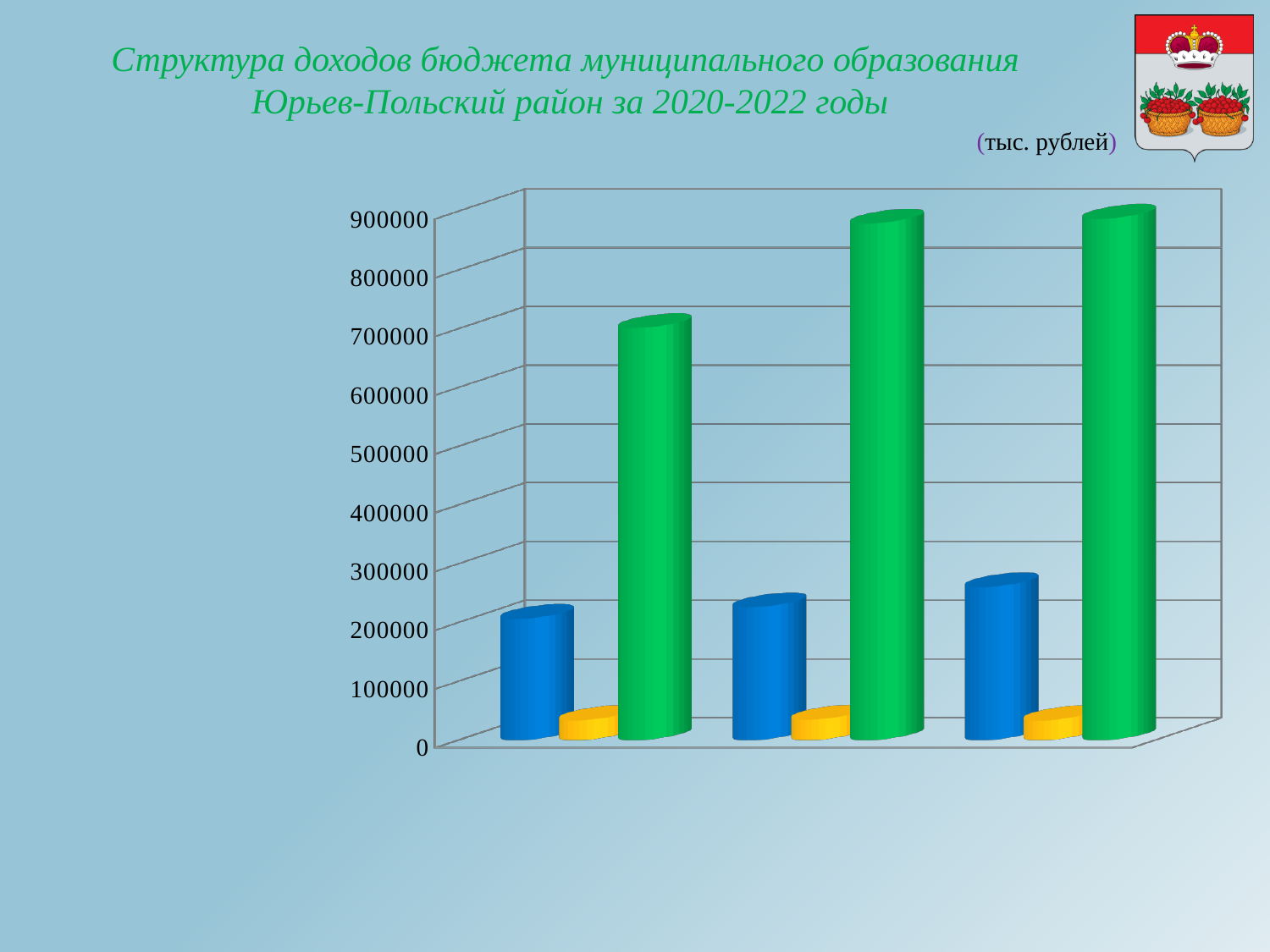
Is the value of the green bar in the middle group greater or less than 800000? greater What kind of chart is shown on the slide? bar chart In what units are the chart values given, according to the slide? тыс. рублей Is the value of the blue bar in the leftmost group greater or less than 300000? less Is the value of the yellow bar in the rightmost group greater or less than 100000? less In the rightmost group, which is larger: the green bar or the blue bar? the green bar How many groups of bars are plotted on the chart? 3 Do the blue bars rise or fall from the leftmost group to the rightmost group? rise How many bars are there in each group on the chart? 3 What is the highest value shown on the vertical axis of the chart? 900000